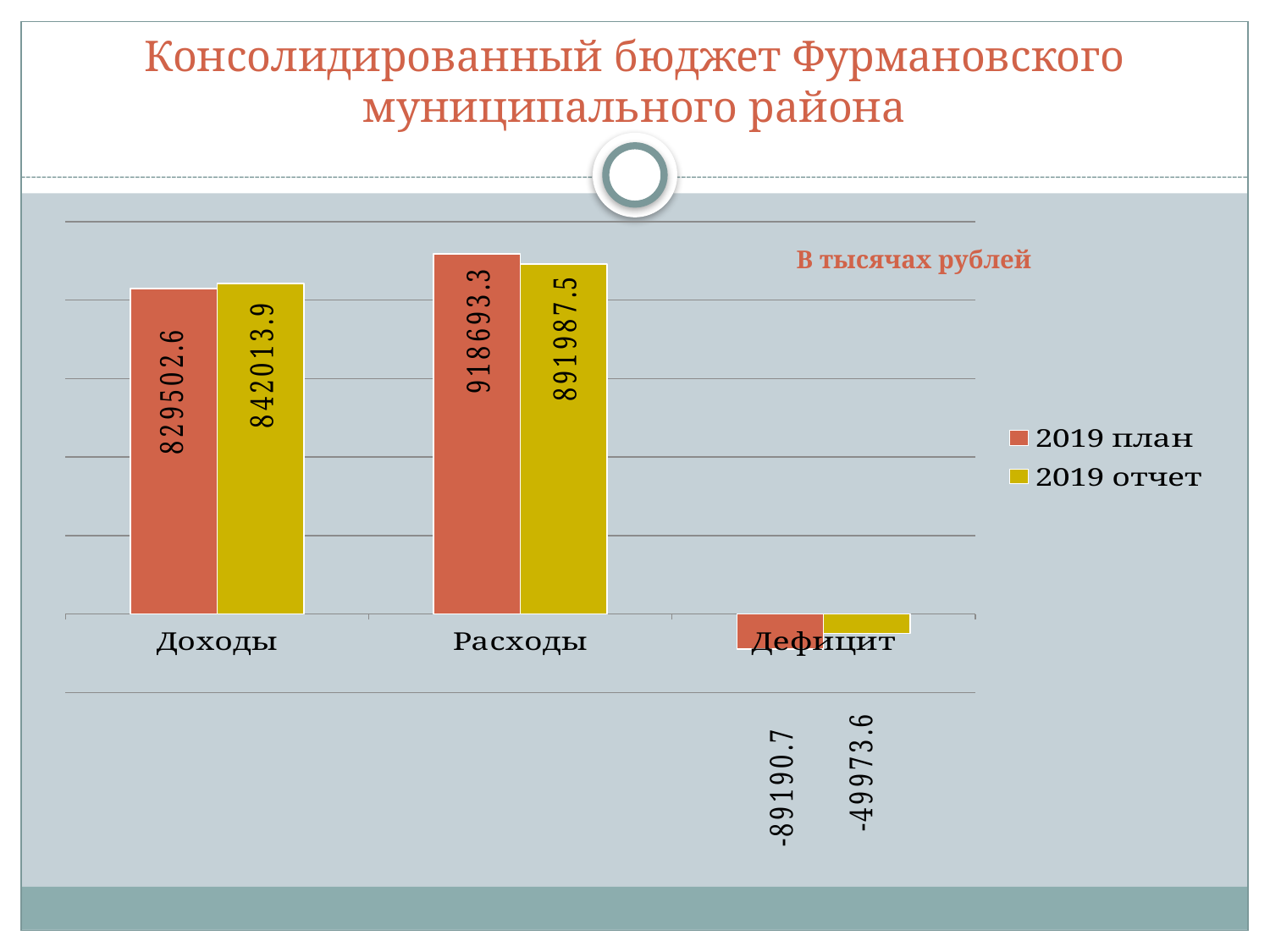
Which category has the highest 2019 план value? Расходы What is the 2019 план value for Расходы? 918693.3 What is the 2019 отчет value for Дефицит? -49973.6 What is the 2019 отчет value for Расходы? 891987.5 How many series does the legend list? 2 What kind of chart is shown on the slide? Bar chart What is the 2019 план value for Дефицит? -89190.7 What is the 2019 план value for Доходы? 829502.6 What is the difference between the 2019 план and 2019 отчет values for Расходы? 26705.8 What is the 2019 отчет value for Доходы? 842013.9 For Доходы, which is larger: the 2019 план value or the 2019 отчет value? 2019 отчет Which category has the lowest 2019 отчет value? Дефицит